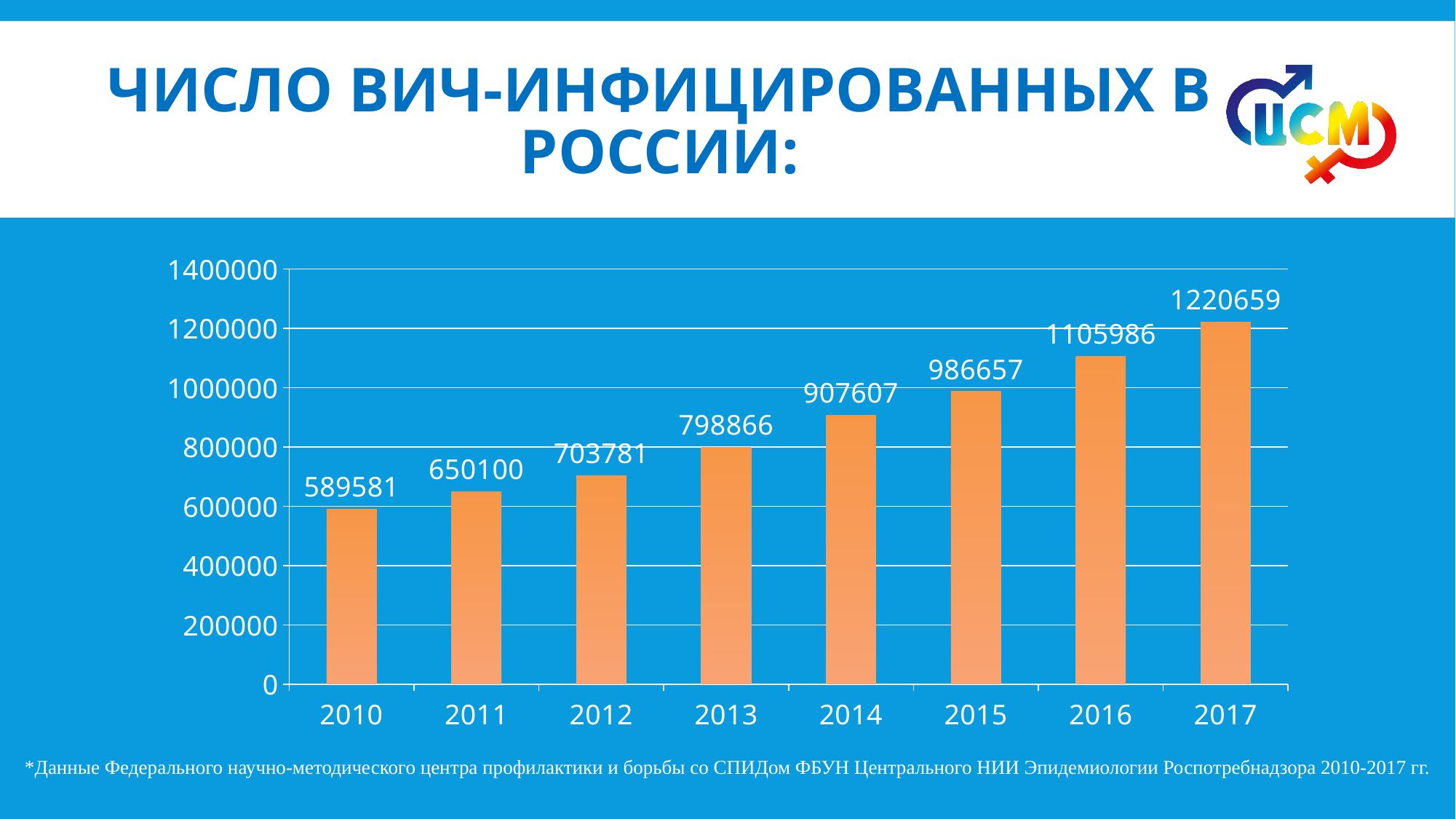
What is the difference between the values for 2016 and 2015? 119329 What is the value for 2017? 1220659 Do the values rise or fall from 2010 to 2017? rise Which is larger, the value for 2013 or the value for 2012? 2013 What is the value for 2014? 907607 How many years are shown on the x axis? 8 What is the value for 2010? 589581 What is the difference between the values for 2017 and 2010? 631078 Which year has the highest value? 2017 Which year has the lowest value? 2010 Is the value for 2015 greater or less than 1000000? less What kind of chart is shown on the slide? bar chart